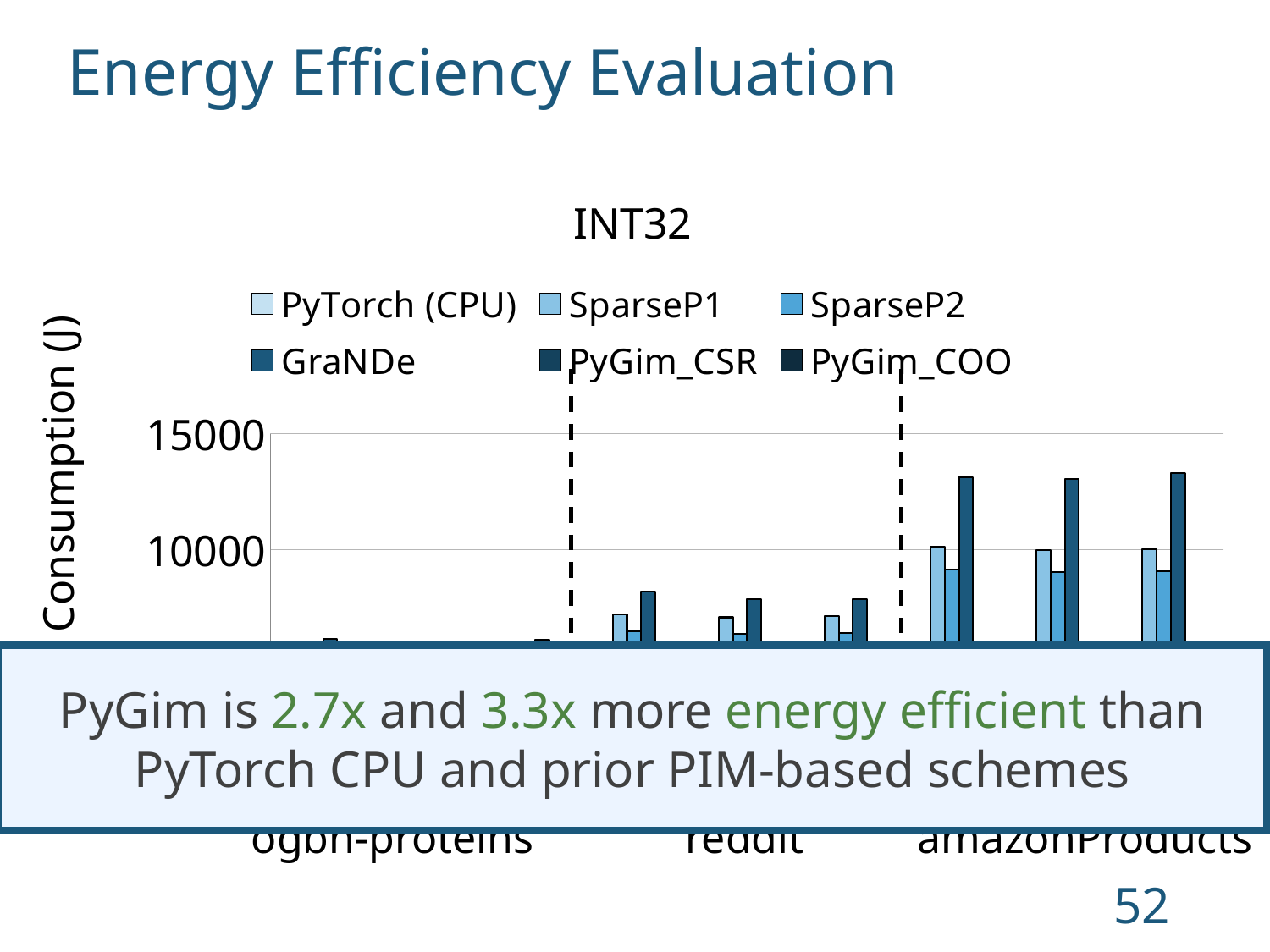
Is the tallest bar in the ogbn-proteins group greater or less than 10000? less Is the tallest bar in the amazonProducts group greater or less than 10000? greater Is the tallest bar in the amazonProducts group greater or less than 15000? less What is the title of the chart? INT32 What kind of chart is shown on the slide? bar chart Which dataset category has the highest energy consumption bars? amazonProducts Which dataset category has the lowest energy consumption bars? ogbn-proteins Which group has higher bars, reddit or amazonProducts? amazonProducts How many dataset categories are labelled on the x axis? 3 What is the label of the y axis? Consumption (J) Do the energy consumption values rise or fall moving from ogbn-proteins to amazonProducts along the x axis? rise How many series does the legend of the INT32 chart list? 6